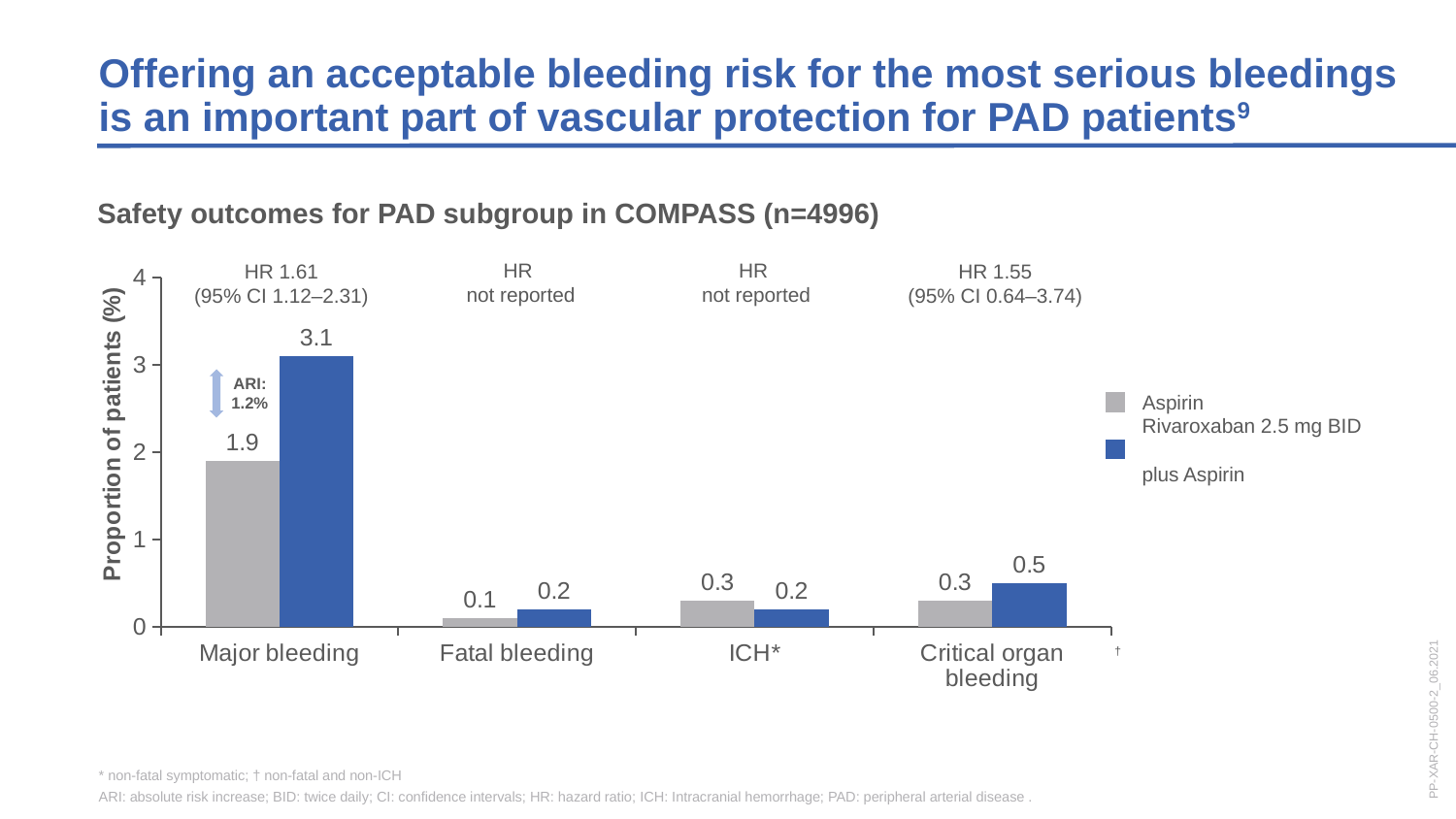
What type of chart is shown on the slide? Bar chart How many bleeding categories are shown on the x axis? 4 What is the value for critical organ bleeding in the Aspirin group? 0.3 For ICH*, which group has the larger value, Aspirin or Rivaroxaban 2.5 mg BID plus Aspirin? Aspirin How many series does the legend list? 2 Which category has the highest value for the Rivaroxaban 2.5 mg BID plus Aspirin series? Major bleeding What is the difference between the Rivaroxaban 2.5 mg BID plus Aspirin and Aspirin values for major bleeding? 1.2 What is the value for fatal bleeding in the Rivaroxaban 2.5 mg BID plus Aspirin group? 0.2 What is the proportion of patients with major bleeding in the Rivaroxaban 2.5 mg BID plus Aspirin group? 3.1 Which category has the lowest value for the Aspirin series? Fatal bleeding Is the value for major bleeding in the Rivaroxaban 2.5 mg BID plus Aspirin group greater or less than 3? greater What is the proportion of patients with major bleeding in the Aspirin group? 1.9